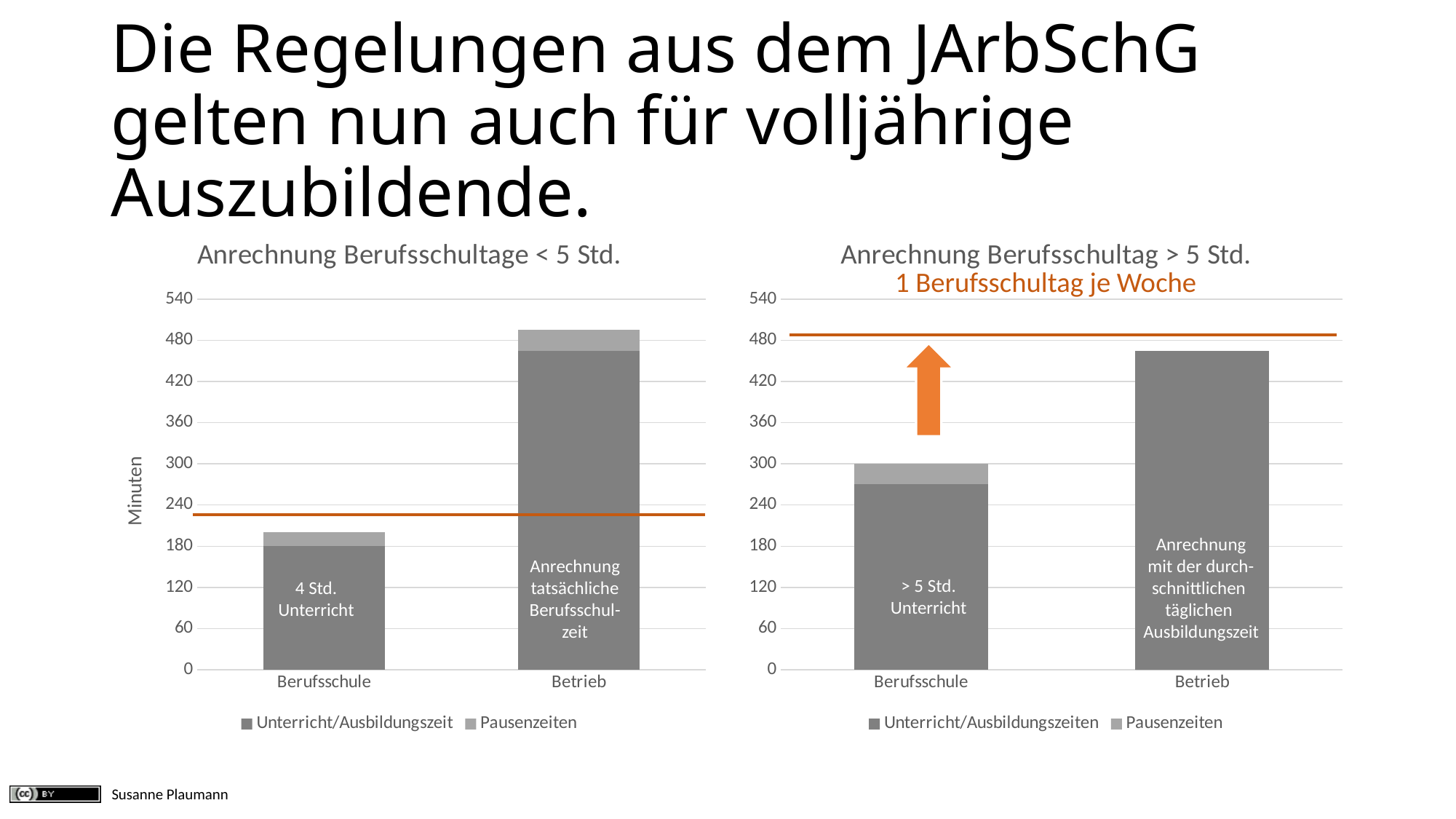
In the left chart 'Anrechnung Berufsschultage < 5 Std.', is the Unterricht/Ausbildungszeit value for Betrieb greater or less than 420? greater In the left chart 'Anrechnung Berufsschultage < 5 Std.', what is the Unterricht/Ausbildungszeit value for Berufsschule in Minuten? 180 In the right chart 'Anrechnung Berufsschultag > 5 Std.', what is the total height of the stacked Berufsschule bar in Minuten? 300 What kind of chart is the left chart, 'Anrechnung Berufsschultage < 5 Std.'? stacked bar chart In the right chart 'Anrechnung Berufsschultag > 5 Std.', is the value for Betrieb greater or less than 420? greater In the left chart 'Anrechnung Berufsschultage < 5 Std.', which category has the taller bar, Berufsschule or Betrieb? Betrieb In the right chart 'Anrechnung Berufsschultag > 5 Std.', which category has the lowest total bar? Berufsschule In the left chart 'Anrechnung Berufsschultage < 5 Std.', how many categories are shown on the x axis? 2 What orange text appears below the title of the right chart 'Anrechnung Berufsschultag > 5 Std.'? 1 Berufsschultag je Woche In the right chart 'Anrechnung Berufsschultag > 5 Std.', how many series does the legend list? 2 What is the label on the y axis of the left chart 'Anrechnung Berufsschultage < 5 Std.'? Minuten In the right chart 'Anrechnung Berufsschultag > 5 Std.', is the Unterricht/Ausbildungszeiten value for Berufsschule greater or less than 300? less